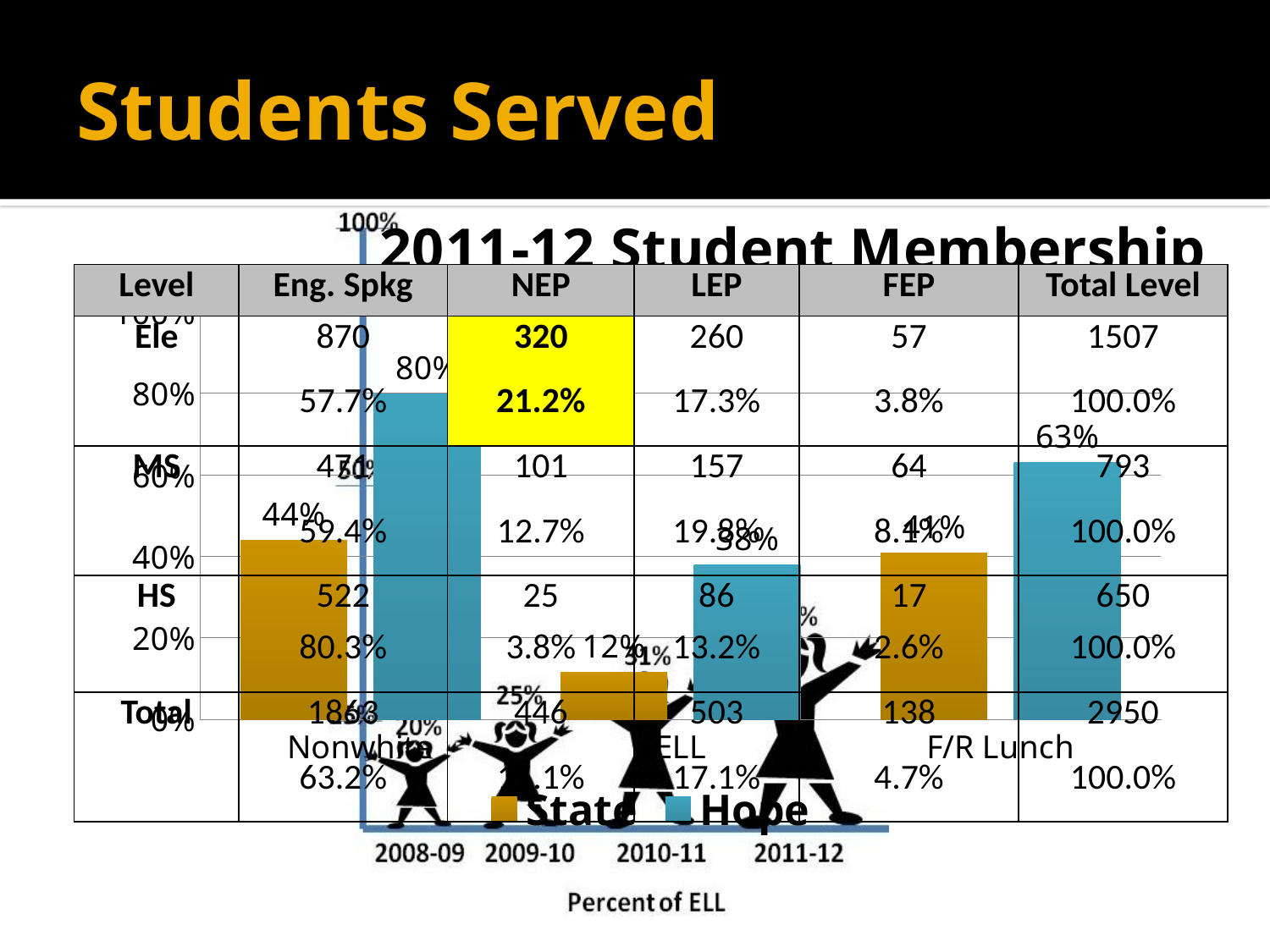
In the bar chart, which category has the lowest Hope value? ELL In the bar chart, which category has the highest Hope value? Nonwhite What are the two series named in the legend of the bar chart? State and Hope In the bar chart, which is larger for Nonwhite, the State value or the Hope value? Hope In the bar chart, what is the Hope value for Nonwhite? 80% In the bar chart, what is the Hope value for ELL? 38% How many categories are shown on the x axis of the bar chart (Nonwhite, ELL, F/R Lunch)? 3 In the bar chart, what is the difference between the Hope and State values for Nonwhite? 36% In the bar chart, what is the State value for Nonwhite? 44% In the bar chart, what is the Hope value for F/R Lunch? 63% How many series does the legend of the bar chart list? 2 What kind of chart is shown behind the table on the slide? bar chart